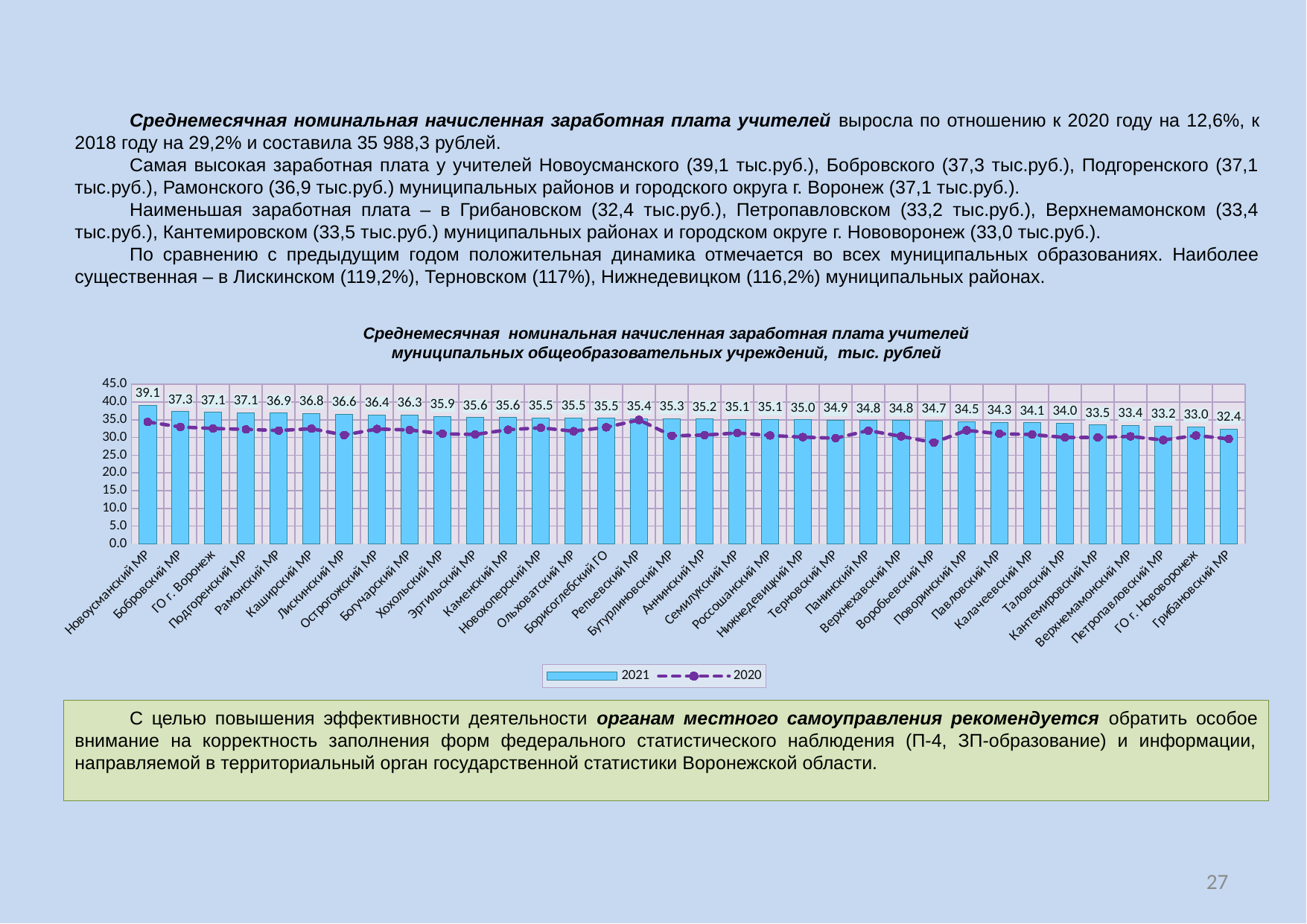
Which category has the lowest 2021 value? Грибановский МР Which category has the highest 2021 value? Новоусманский МР What is the 2021 value for Грибановский МР? 32.4 How many categories are shown on the x axis? 34 What is the 2021 value for Лискинский МР? 36.6 Do the 2021 values rise or fall from left to right along the x axis? fall How many series does the legend list? 2 What is the 2021 value for Новоусманский МР? 39.1 What is the difference between the 2021 values for Новоусманский МР and Грибановский МР? 6.7 What is the 2021 value for ГО г. Нововоронеж? 33.0 Which has the larger 2021 value, Бобровский МР or Кантемировский МР? Бобровский МР Is the 2020 value for Репьевский МР greater or less than 30.0? greater